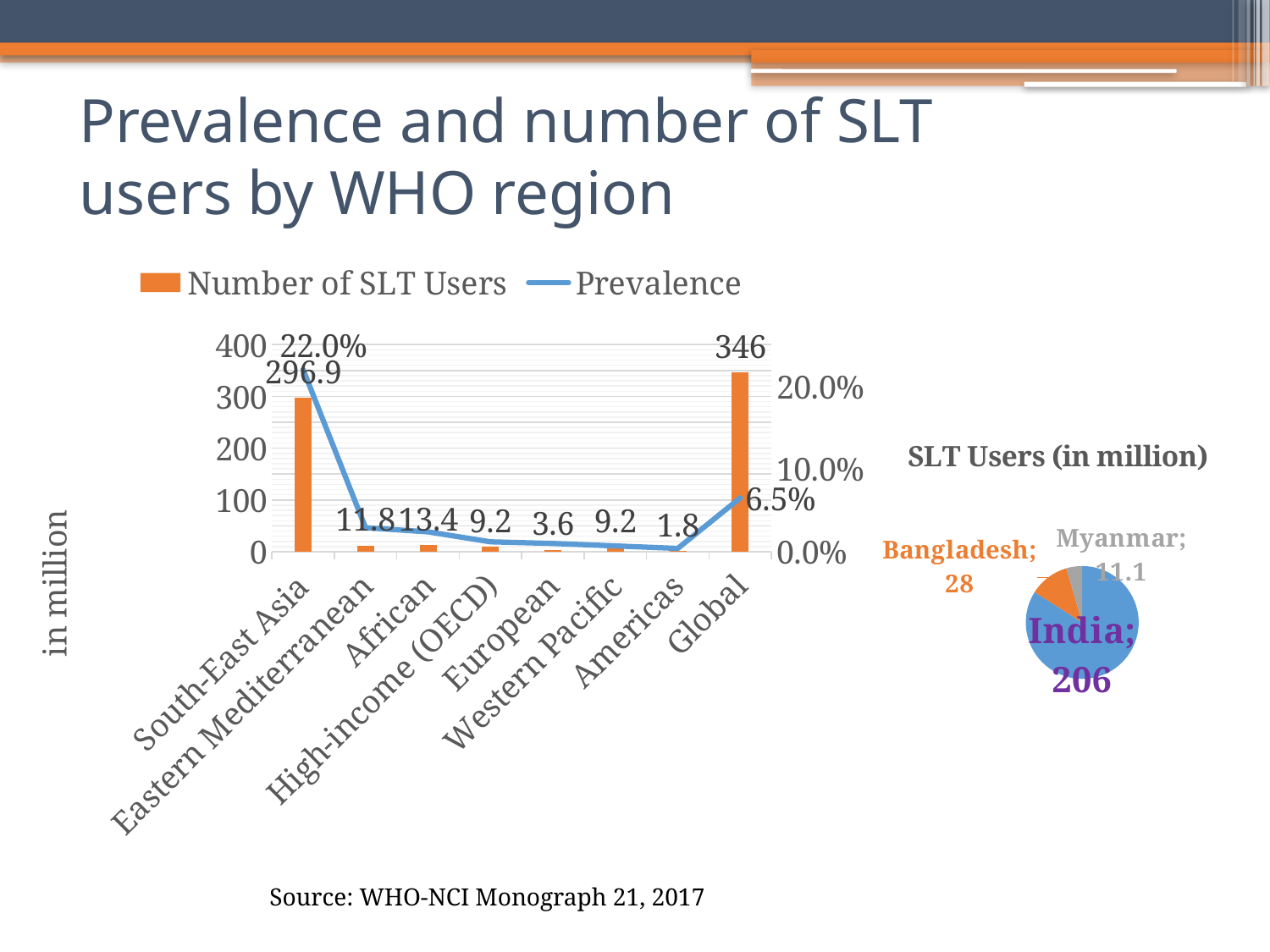
In the pie chart titled 'SLT Users (in million)', what is the difference between the values for India and Bangladesh? 178 In the pie chart titled 'SLT Users (in million)', what is the value for India? 206 How many series does the legend of the left chart list? 2 In the left chart, what is the number of SLT users (in million) for South-East Asia? 296.9 In the left chart, what is the prevalence value shown for South-East Asia? 22.0% In the left chart, what is the prevalence value shown for Global? 6.5% In the left chart, what is the number of SLT users (in million) for the Global category? 346 In the left chart, what is the difference between the number of SLT users for Global and for South-East Asia? 49.1 How many categories are shown on the x axis of the left chart? 8 In the left chart, which category has the lowest number of SLT users? Americas In the left chart, which has more SLT users: African or Eastern Mediterranean? African In the left chart, is the prevalence for the African region greater or less than 10.0%? less